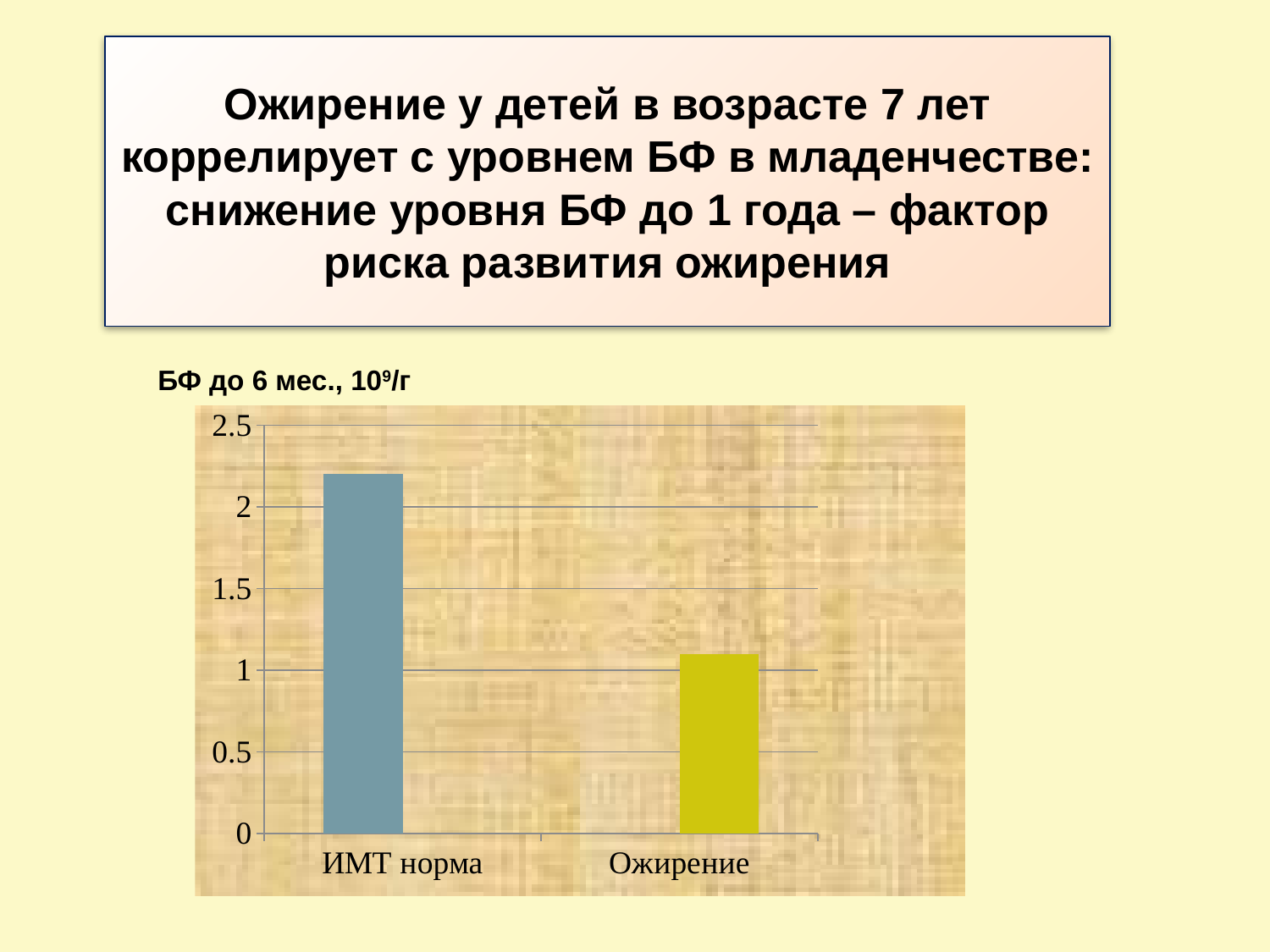
Do the bar values rise or fall from ИМТ норма to Ожирение? fall Is the value for Ожирение greater or less than 1.5? less Which category has the lowest bar in the chart? Ожирение Is the value for ИМТ норма greater or less than 2.5? less Which is larger, the value for ИМТ норма or the value for Ожирение? ИМТ норма Which category has the highest bar in the chart? ИМТ норма What kind of chart is shown on the slide? bar chart What is the label printed above the chart describing the plotted quantity? БФ до 6 мес., 10⁹/г Is the value for ИМТ норма greater or less than 2? greater What is the highest tick value shown on the vertical axis of the chart? 2.5 How many categories are shown on the x axis of the chart? 2